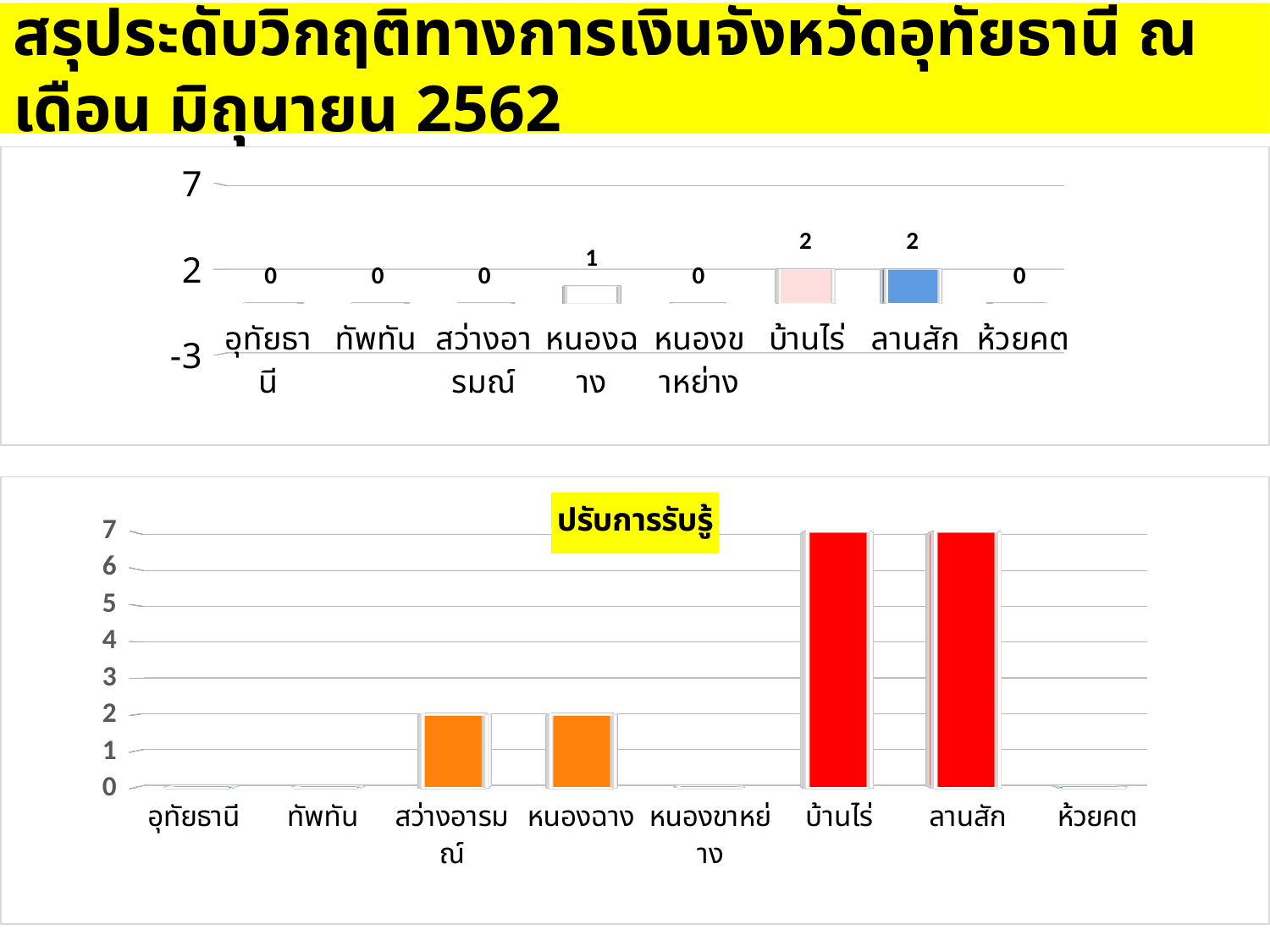
In the top chart, which is larger, the value for หนองฉาง or the value for ทัพทัน? หนองฉาง In the top chart, what is the difference between the values for ลานสัก and หนองฉาง? 1 In the bottom chart titled ปรับการรับรู้, what is the value for สว่างอารมณ์? 2 What is the title of the bottom chart? ปรับการรับรู้ In the bottom chart titled ปรับการรับรู้, what is the value for บ้านไร่? 7 What kind of chart is the bottom chart titled ปรับการรับรู้? bar chart In the bottom chart titled ปรับการรับรู้, is the value for บ้านไร่ greater or less than 5? greater In the top chart, what is the value for ห้วยคต? 0 In the top chart, how many categories are shown on the x axis? 8 In the top chart, what is the value for บ้านไร่? 2 In the bottom chart titled ปรับการรับรู้, which is larger, the value for ลานสัก or the value for หนองฉาง? ลานสัก In the top chart, what is the value for หนองฉาง? 1